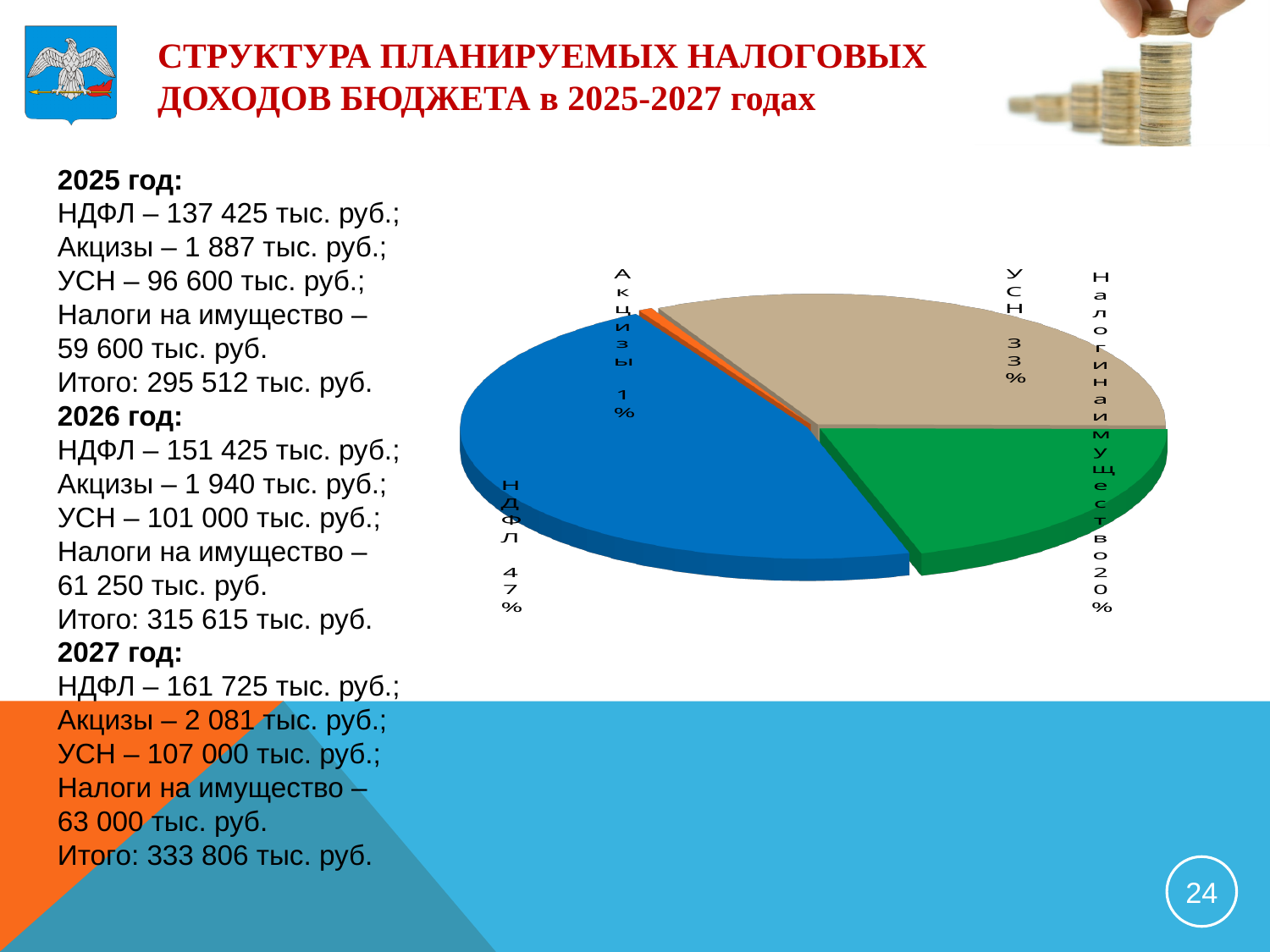
What kind of chart is shown on the slide? pie chart What share of the pie does Налоги на имущество account for? 20% How many slices does the pie chart have? 4 What share of the pie does УСН account for? 33% What colour is the НДФЛ slice of the pie? blue What share of the pie does Акцизы account for? 1% What colour is the Налоги на имущество slice of the pie? green Which is larger in the pie chart, УСН or Налоги на имущество? УСН By how many percentage points does the НДФЛ share exceed the УСН share? 14 Which category has the smallest slice of the pie? Акцизы Which category has the largest slice of the pie? НДФЛ